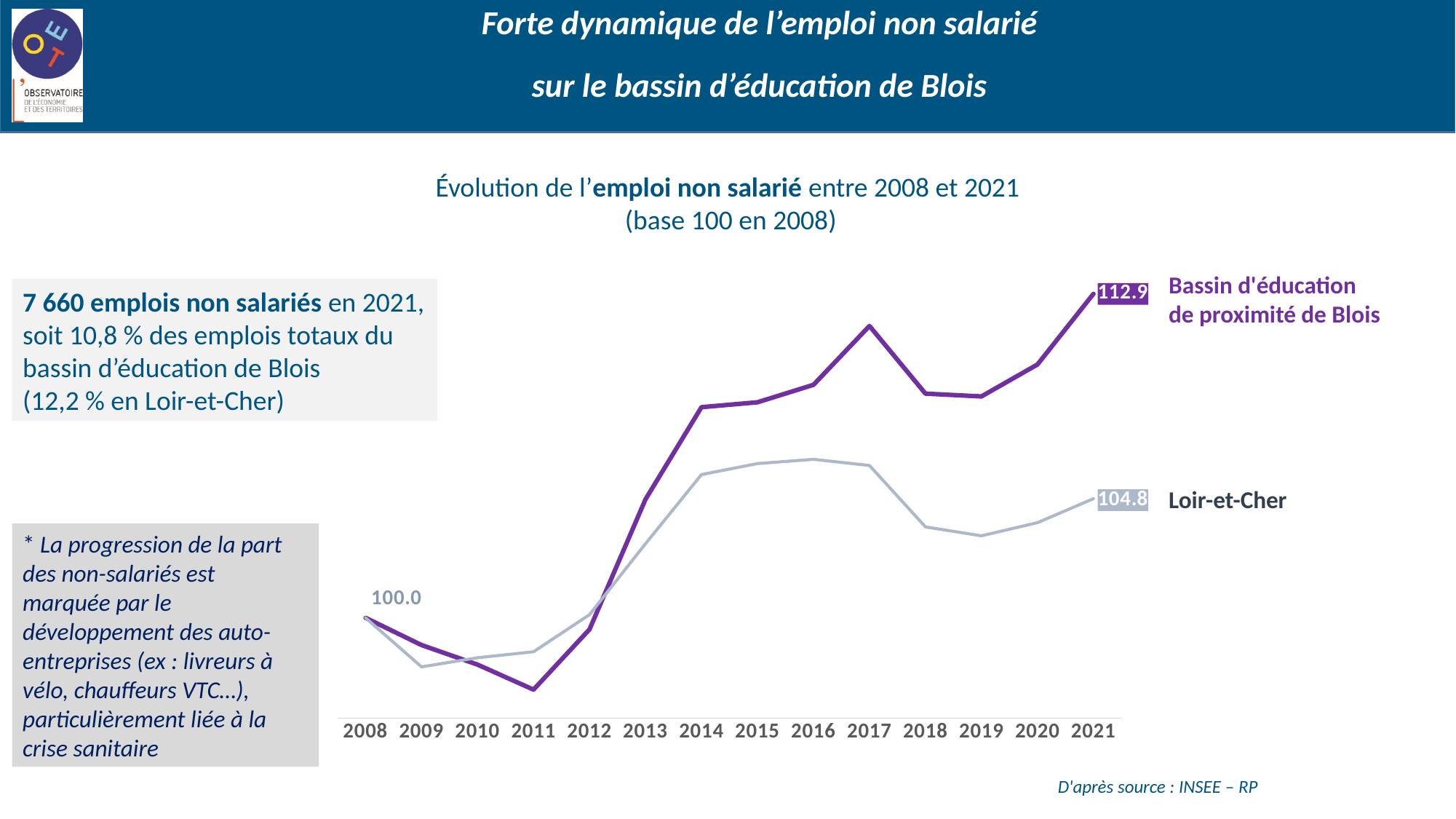
How many series are plotted on the chart? 2 Overall, does the Bassin d'éducation de proximité de Blois line rise or fall between 2008 and 2021? Rise What is the value for Loir-et-Cher in 2021? 104.8 By how much did the index for the Bassin d'éducation de proximité de Blois increase between 2008 and 2021? 12.9 In which year does the Bassin d'éducation de proximité de Blois line reach its highest point? 2021 How many years are shown on the x axis? 14 What is the value shown for 2008, the base year? 100.0 What is the difference between the 2021 values for the Bassin d'éducation de proximité de Blois and Loir-et-Cher? 8.1 What is the value for the Bassin d'éducation de proximité de Blois in 2021? 112.9 In which year does the Bassin d'éducation de proximité de Blois line reach its lowest point? 2011 In 2021, which series has the higher value: Bassin d'éducation de proximité de Blois or Loir-et-Cher? Bassin d'éducation de proximité de Blois What type of chart is shown? Line chart